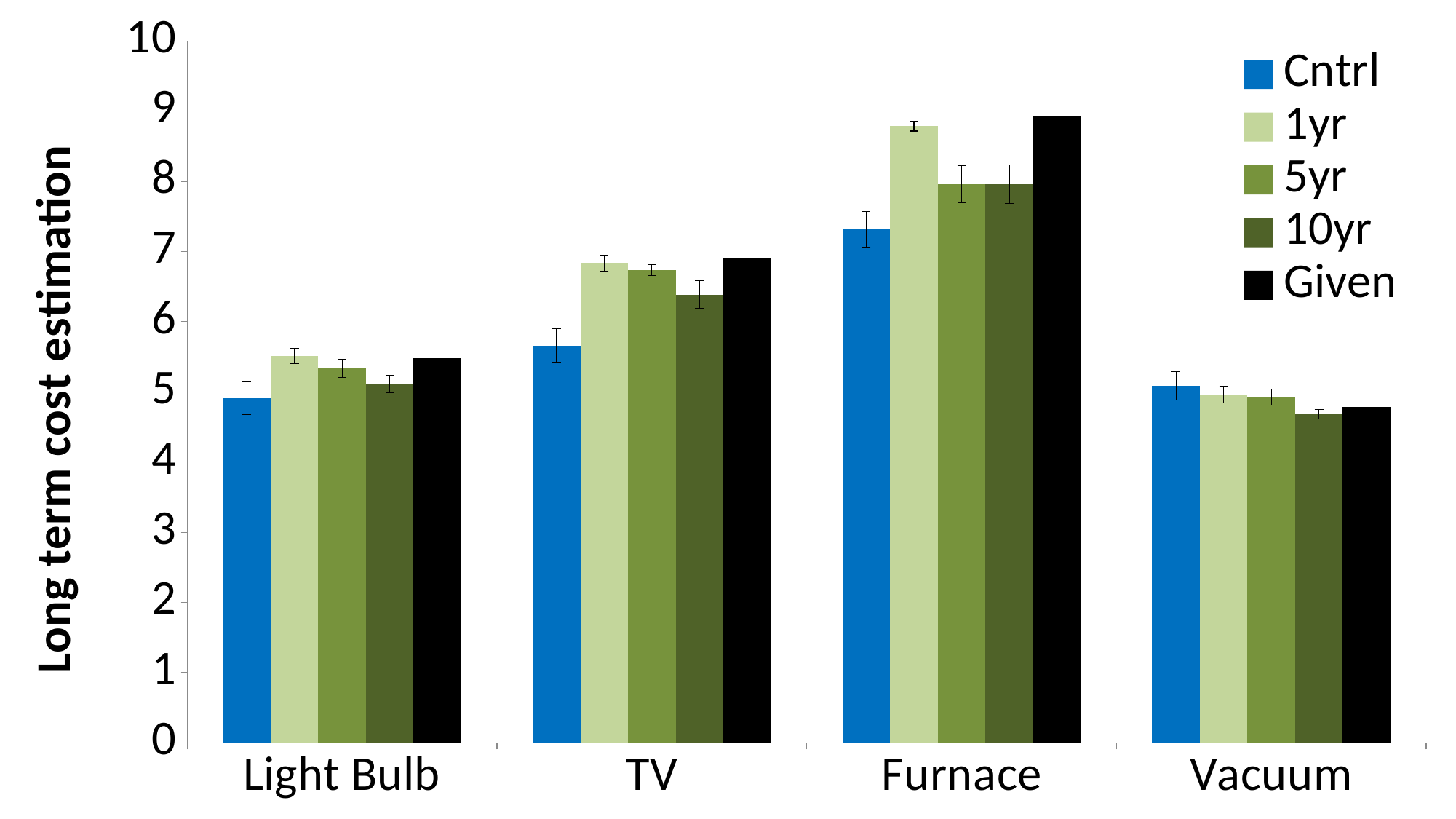
Is the 10yr value for Vacuum greater or less than 5? less How many series does the legend list? 5 What is the label on the y axis? Long term cost estimation What kind of chart is shown on the slide? bar chart Is the 1yr value for Furnace greater or less than 8? greater Is the Cntrl value for Furnace greater or less than 7? greater For Furnace, which is larger: the Given bar or the Cntrl bar? Given For TV, which is larger: the 1yr bar or the 10yr bar? 1yr Which category has the highest Given bar? Furnace Which category has the lowest 10yr bar? Vacuum How many product categories are shown on the x axis? 4